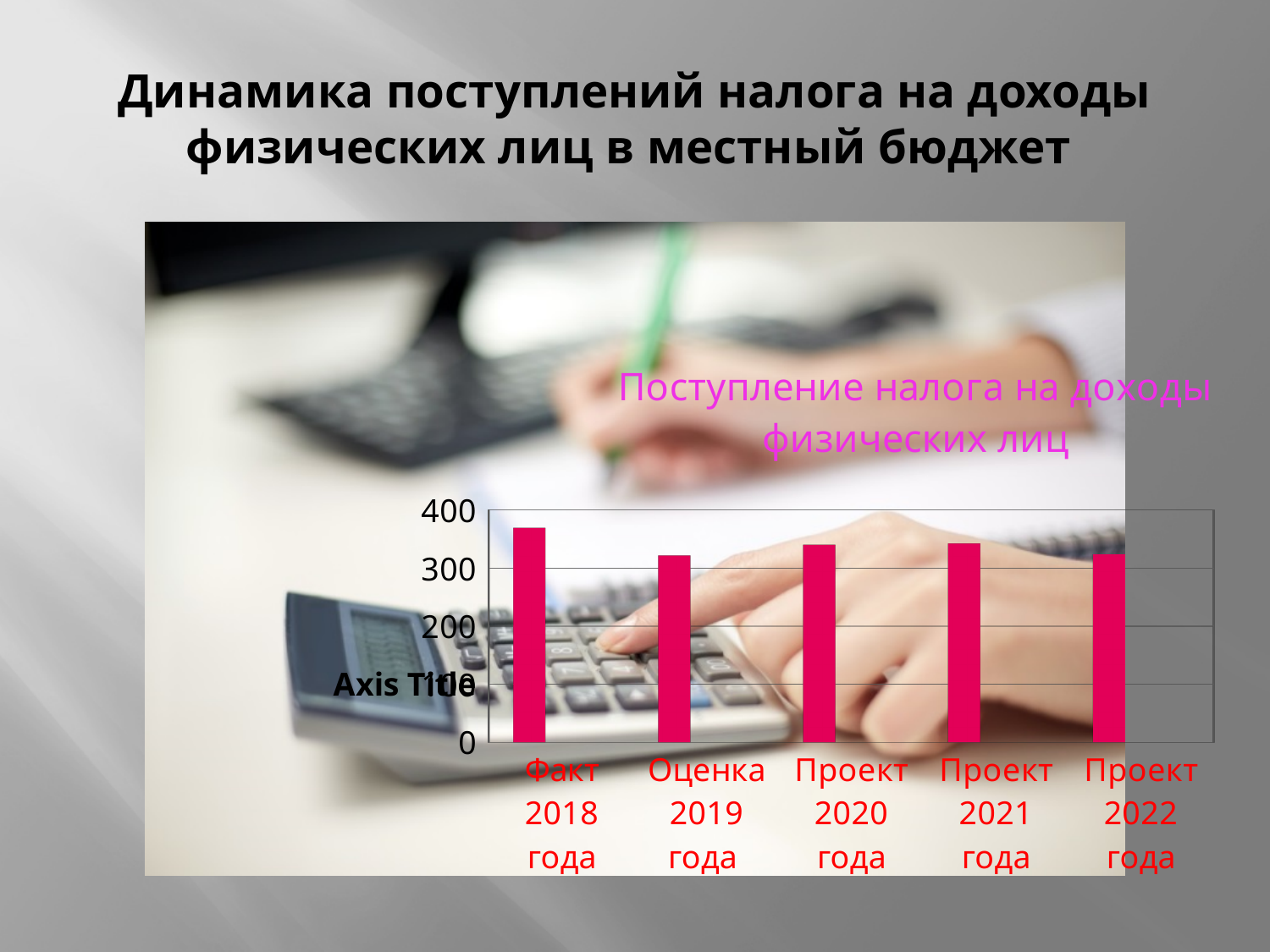
How many categories are shown on the x axis of the chart? 5 Which category has the highest bar in the chart? Факт 2018 года What kind of chart is shown on the slide? bar chart What is the title of the chart? Поступление налога на доходы физических лиц What is the highest value shown on the vertical axis of the chart? 400 Which is larger, the value for Факт 2018 года or the value for Оценка 2019 года? Факт 2018 года Is the value for Проект 2022 года greater or less than 400? less Is the value for Факт 2018 года greater or less than 300? greater Is the value for Факт 2018 года greater or less than 400? less Which is larger, the value for Факт 2018 года or the value for Проект 2022 года? Факт 2018 года